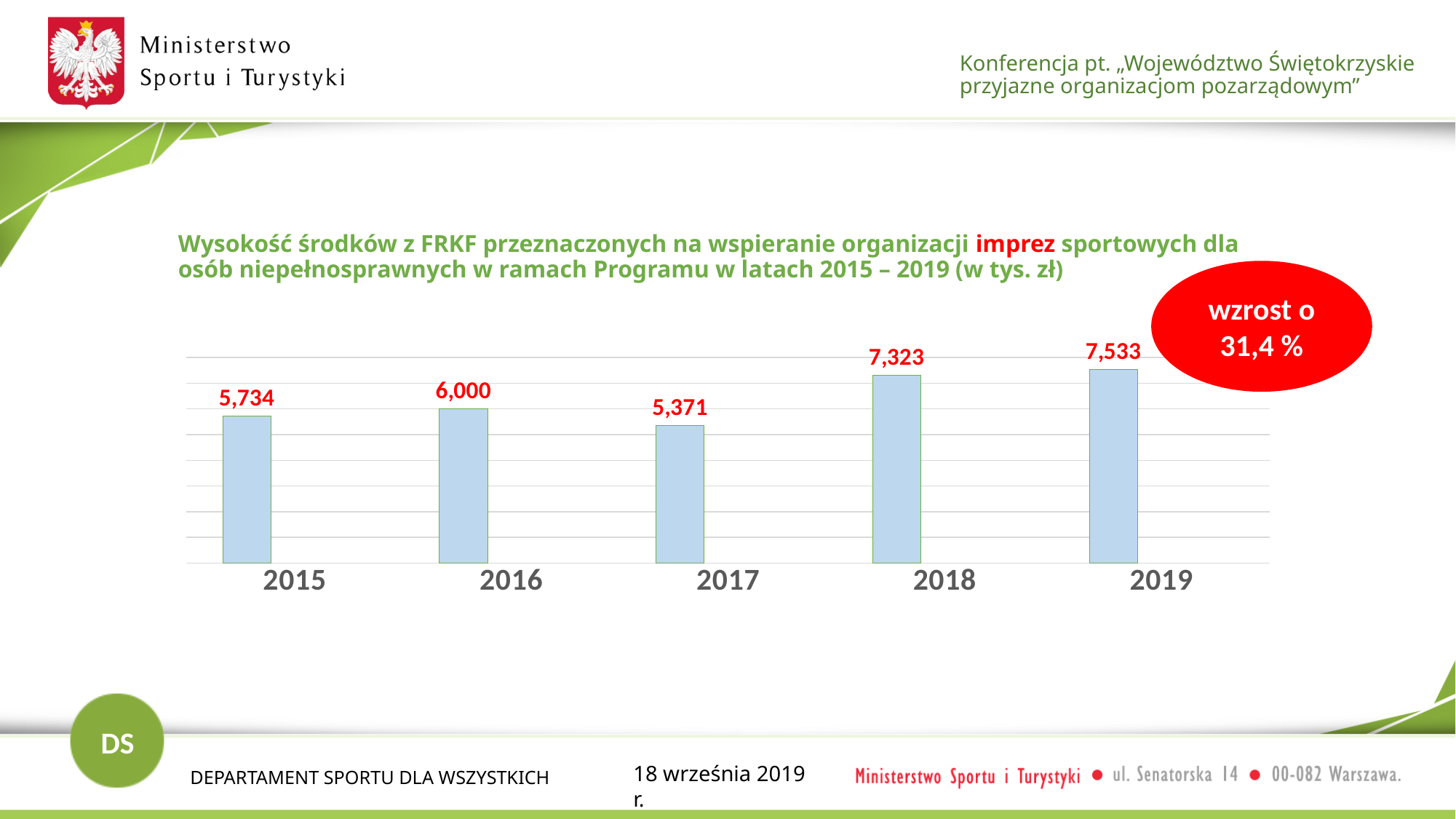
What is the difference between the values for 2019 and 2018? 210 How many years are shown on the x axis? 5 What is the value for 2015? 5,734 What is the difference between the values for 2016 and 2017? 629 What percentage increase is stated in the red oval next to the chart? 31,4 % Which is larger, the value for 2016 or the value for 2015? 2016 What kind of chart is shown on the slide? bar chart Do the values rise or fall from 2017 to 2019? rise Which year has the highest value? 2019 Which year has the lowest value? 2017 What is the value for 2017? 5,371 What is the value for 2019? 7,533